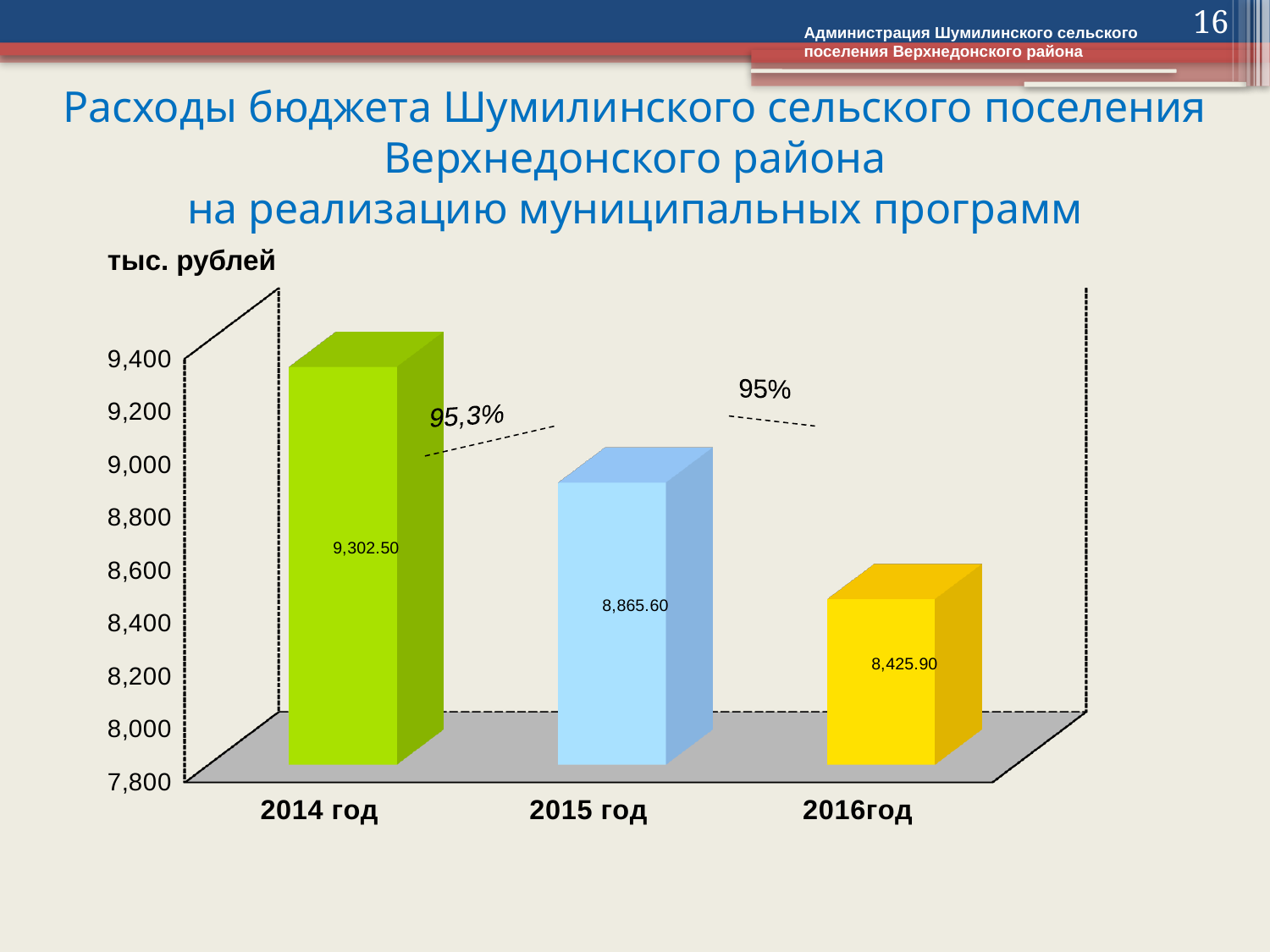
Which year has the highest value? 2014 год What kind of chart is shown on the slide? bar chart What is the difference between the values for 2015 год and 2016год? 439.70 What is the value for 2015 год? 8,865.60 What is the difference between the values for 2014 год and 2015 год? 436.90 Which is larger, the value for 2015 год or the value for 2016год? 2015 год Do the values rise or fall from 2014 год to 2016год? fall Which year has the lowest value? 2016год What is the value for 2014 год? 9,302.50 What is the value for 2016год? 8,425.90 Is the value for 2016год greater or less than 8,600? less How many years are shown on the chart? 3